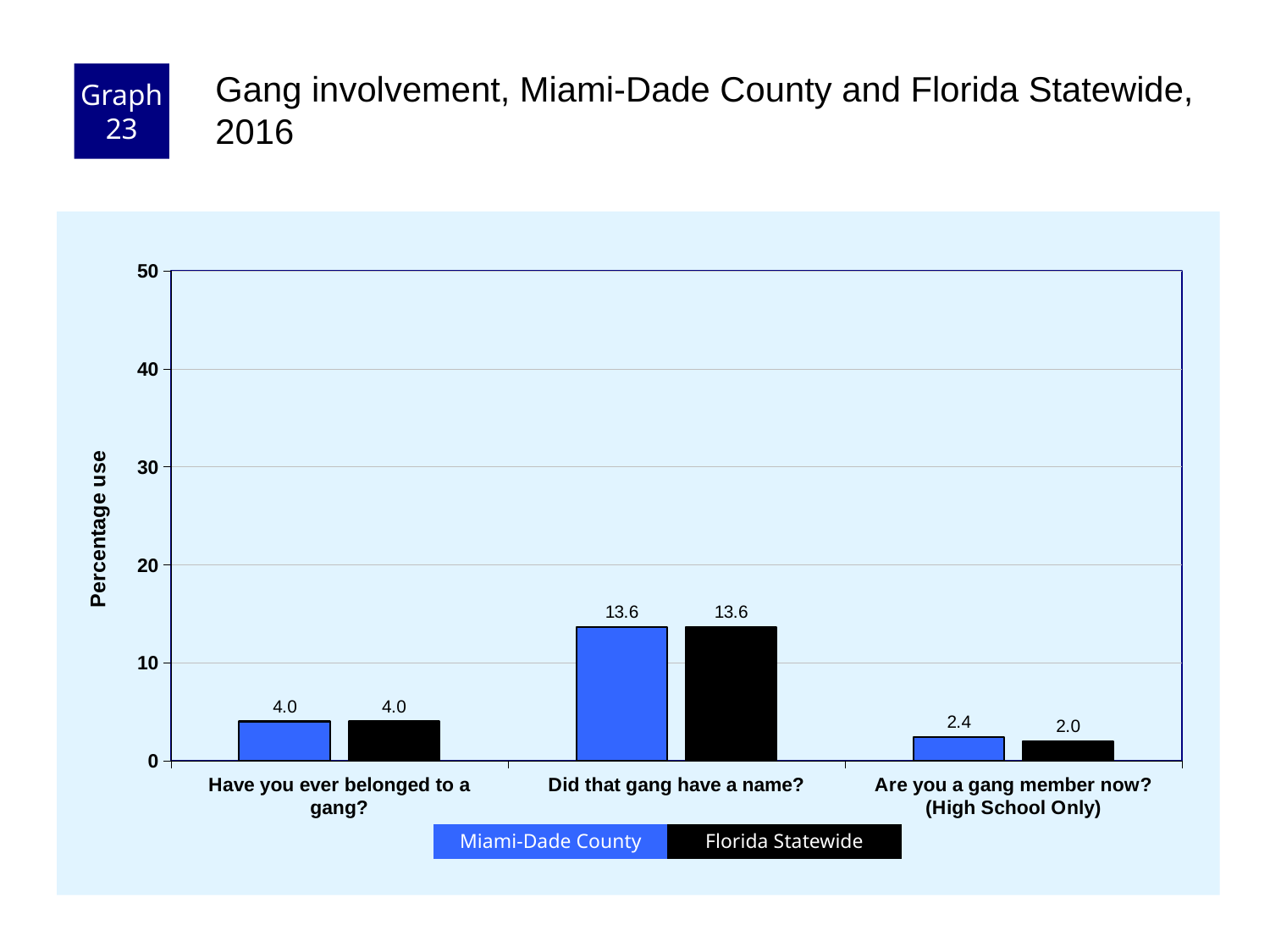
Which question category has the lowest Florida Statewide value? Are you a gang member now? (High School Only) What is the difference between the Miami-Dade County values for "Did that gang have a name?" and "Have you ever belonged to a gang?"? 9.6 How many question categories are shown on the x axis? 3 What is the label of the y axis? Percentage use What is the Florida Statewide value for "Are you a gang member now? (High School Only)"? 2.0 What is the Miami-Dade County value for "Did that gang have a name?"? 13.6 Which question category has the highest Miami-Dade County value? Did that gang have a name? Is the Florida Statewide value for "Did that gang have a name?" greater or less than 10? greater How many series does the legend list? 2 What is the Miami-Dade County value for "Have you ever belonged to a gang?"? 4.0 What is the difference between the Miami-Dade County and Florida Statewide values for "Are you a gang member now? (High School Only)"? 0.4 What kind of chart is shown on the slide? Bar chart